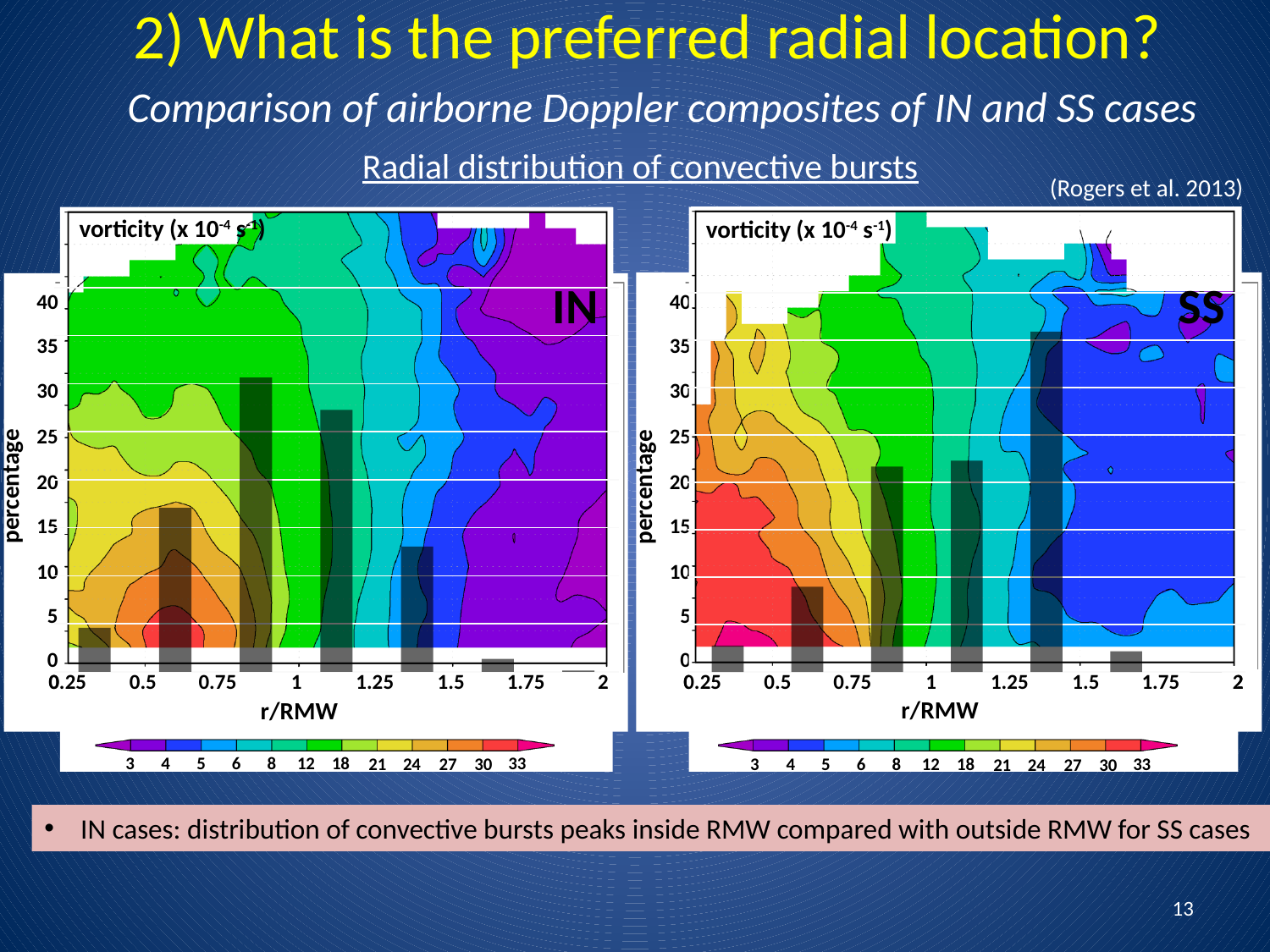
In the IN chart on the left, is the percentage for the bar between r/RMW 0.5 and 0.75 greater or less than 15? greater In the SS chart on the right, is the percentage for the bar between r/RMW 0.5 and 0.75 greater or less than 10? less In the IN chart on the left, between which two r/RMW tick values does the shortest bar lie? 1.5 and 1.75 In the IN chart on the left, which bar is the tallest: the one between r/RMW 0.75 and 1, or the one between 1.25 and 1.5? the one between 0.75 and 1 In the SS chart on the right, how many bars are plotted along the r/RMW axis? 6 In the SS chart on the right, between which two r/RMW tick values does the tallest bar lie? 1.25 and 1.5 What is the label on the x axis of both charts? r/RMW What is the highest value shown on the vorticity colour bar beneath each chart? 33 In the IN chart on the left, how many bars are plotted along the r/RMW axis? 6 Comparing the bar between r/RMW 0.5 and 0.75 in the IN chart with the same bar in the SS chart, which chart shows the larger percentage? IN In the SS chart on the right, is the percentage for the bar between r/RMW 1.25 and 1.5 greater or less than 35? greater